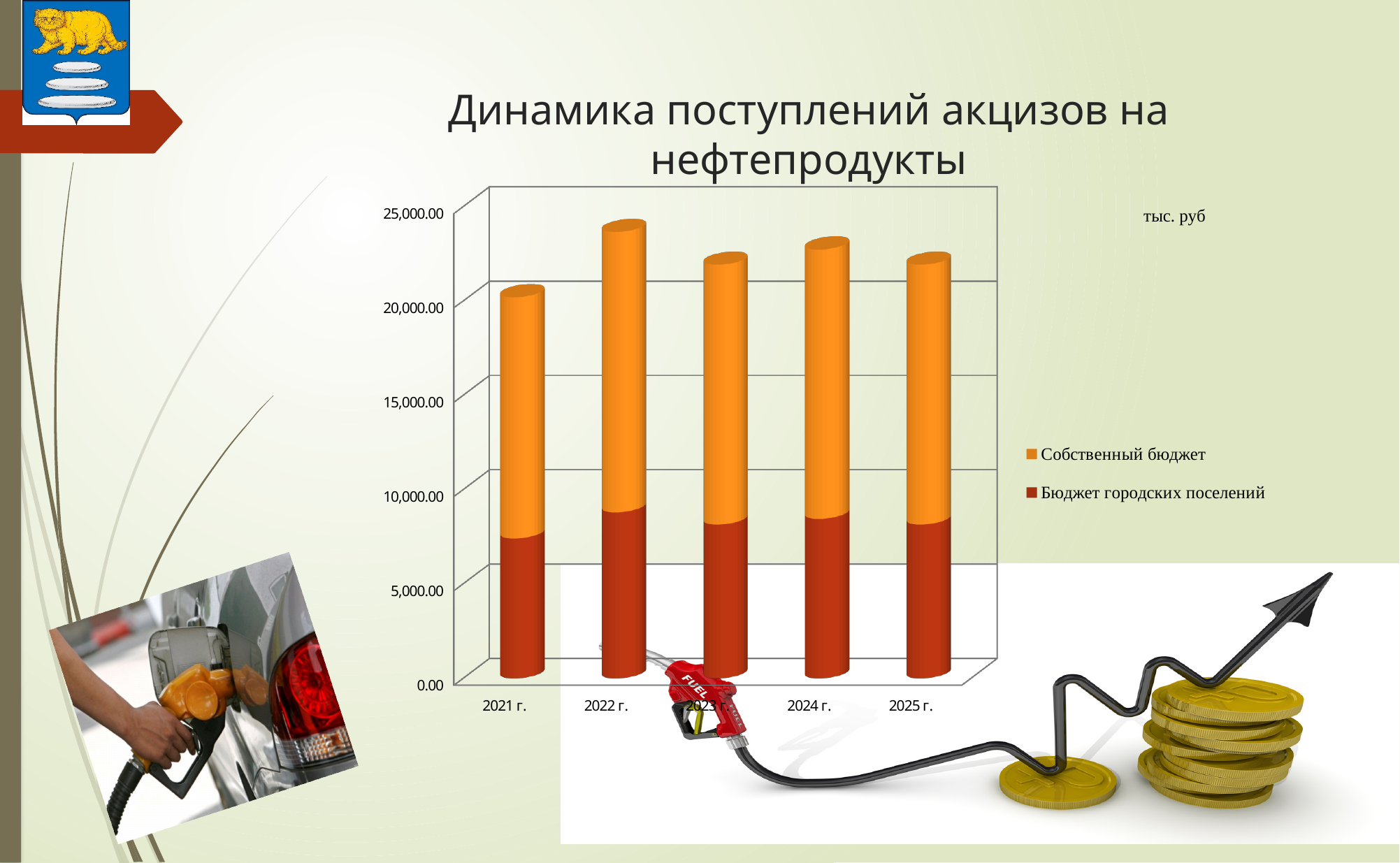
Is the total bar for 2022 г. greater or less than 25,000.00? less How many years are shown on the x axis of the chart? 5 What kind of chart is shown on the slide? bar chart Is the Бюджет городских поселений segment for 2021 г. greater or less than 10,000.00? less Which year has the highest total bar in the chart? 2022 г. How many series does the chart legend list? 2 Which total bar is larger, 2021 г. or 2022 г.? 2022 г. Which legend entry is shown in orange? Собственный бюджет Which year has the lowest total bar in the chart? 2021 г. Does the total bar rise or fall from 2021 г. to 2022 г.? rise Is the total bar for 2022 г. greater or less than 20,000.00? greater What is the title of the chart? Динамика поступлений акцизов на нефтепродукты